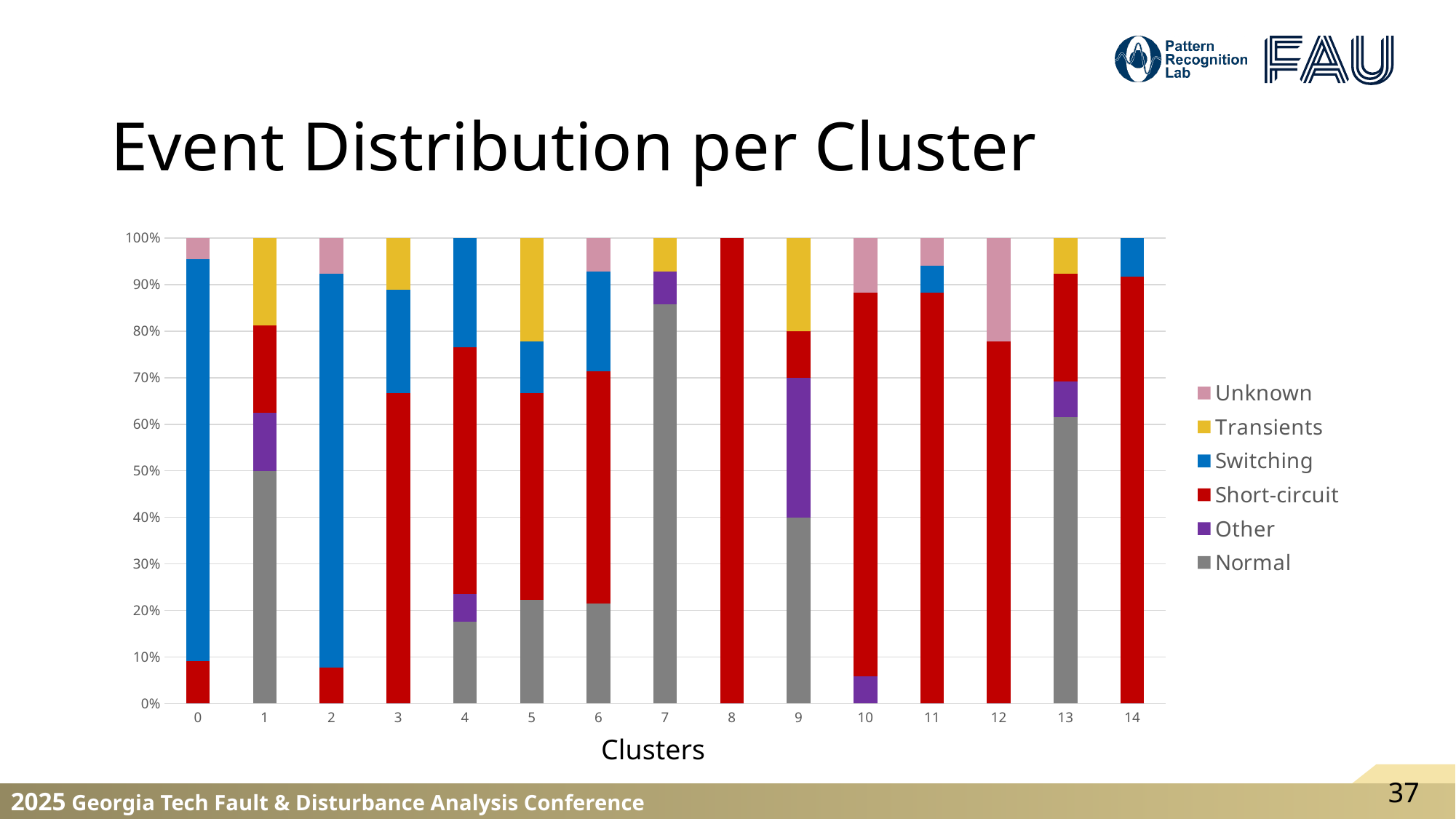
Which cluster has the largest Normal share? 7 Is the Switching share for cluster 0 greater or less than 80%? greater Is the Short-circuit share for cluster 3 greater or less than 60%? greater Is the Normal share for cluster 7 greater or less than 80%? greater What kind of chart is shown on the slide? Stacked bar chart How many series does the legend list? 6 What share of events in cluster 8 are Short-circuit? 100% How many clusters are shown along the x axis? 15 What is the label of the x axis? Clusters What is the title of the chart? Event Distribution per Cluster Which has the larger Normal share, cluster 7 or cluster 13? Cluster 7